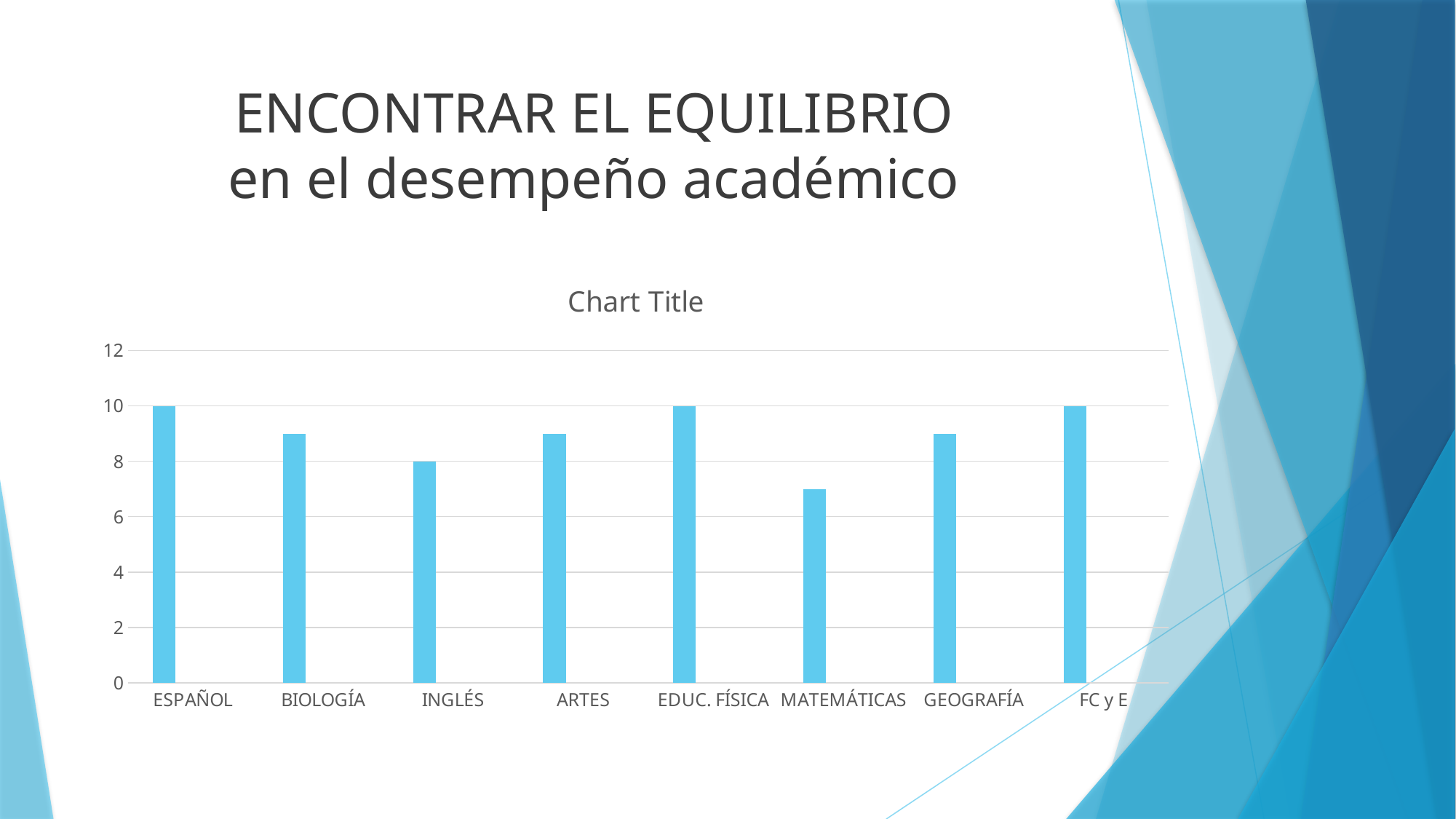
What is the title of the chart? Chart Title Which is larger, the value for ESPAÑOL or the value for MATEMÁTICAS? ESPAÑOL How many categories are shown on the x axis? 8 Is the value for BIOLOGÍA greater or less than 8? greater What is the value for INGLÉS? 8 Is the value for MATEMÁTICAS greater or less than 8? less What is the difference between the values for ESPAÑOL and INGLÉS? 2 What is the value for EDUC. FÍSICA? 10 What is the value for FC y E? 10 What kind of chart is shown on the slide? bar chart What is the value for ESPAÑOL? 10 Which category has the lowest value? MATEMÁTICAS